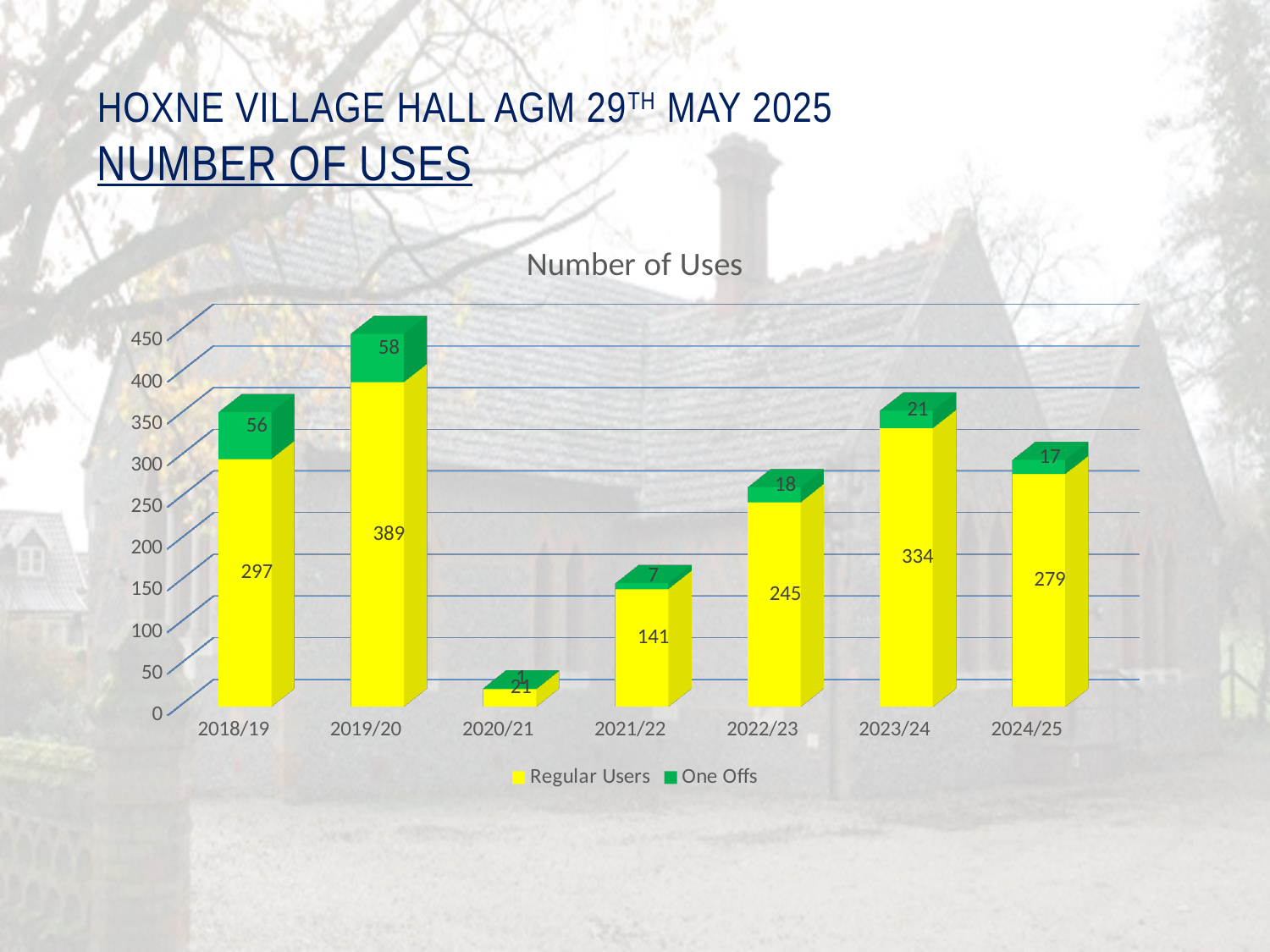
Which colour represents One Offs in the chart? Green Which is larger, Regular Users in 2018/19 or Regular Users in 2024/25? 2018/19 What is the total of the stacked bar for 2019/20? 447 Which year has the lowest value for Regular Users? 2020/21 How many series does the legend list? 2 What is the value for One Offs in 2018/19? 56 What type of chart is shown on the slide? Stacked bar chart Which year has the highest value for Regular Users? 2019/20 What is the difference between Regular Users in 2023/24 and 2022/23? 89 What is the value for Regular Users in 2024/25? 279 What is the value for Regular Users in 2019/20? 389 How many year categories are shown on the x axis? 7